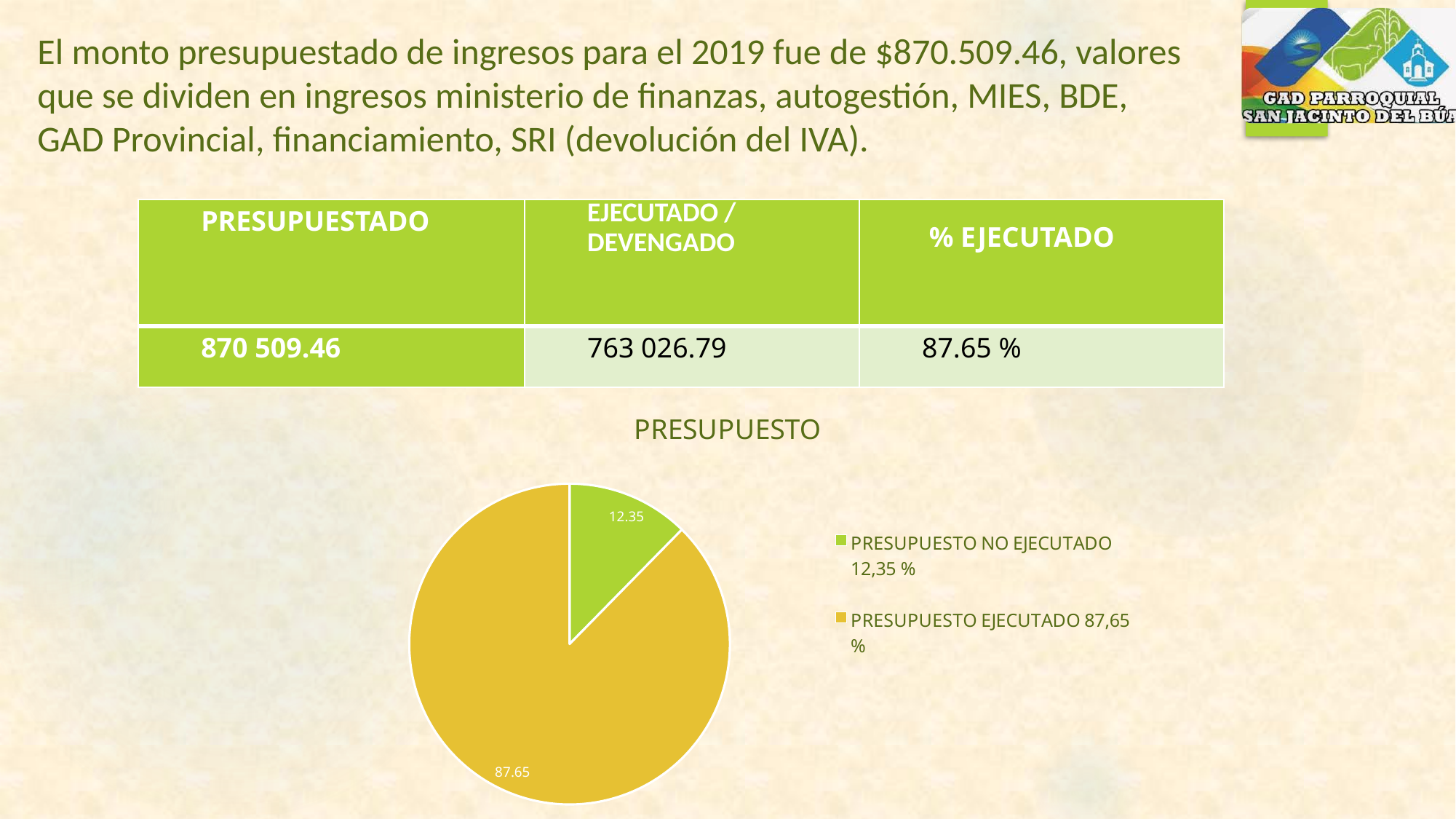
What is the difference between the PRESUPUESTO EJECUTADO and PRESUPUESTO NO EJECUTADO values? 75.3 What value is shown for the PRESUPUESTO NO EJECUTADO slice? 12.35 Which slice of the pie is the largest? PRESUPUESTO EJECUTADO What value is shown for the PRESUPUESTO EJECUTADO slice? 87.65 What kind of chart is shown on the slide? pie chart What colour is the PRESUPUESTO NO EJECUTADO slice? green What share of the pie does the PRESUPUESTO EJECUTADO slice represent? 87.65% Which slice of the pie is the smallest? PRESUPUESTO NO EJECUTADO How many entries does the legend list? 2 How many slices does the pie chart have? 2 What is the title of the chart? PRESUPUESTO Which is larger, PRESUPUESTO EJECUTADO or PRESUPUESTO NO EJECUTADO? PRESUPUESTO EJECUTADO